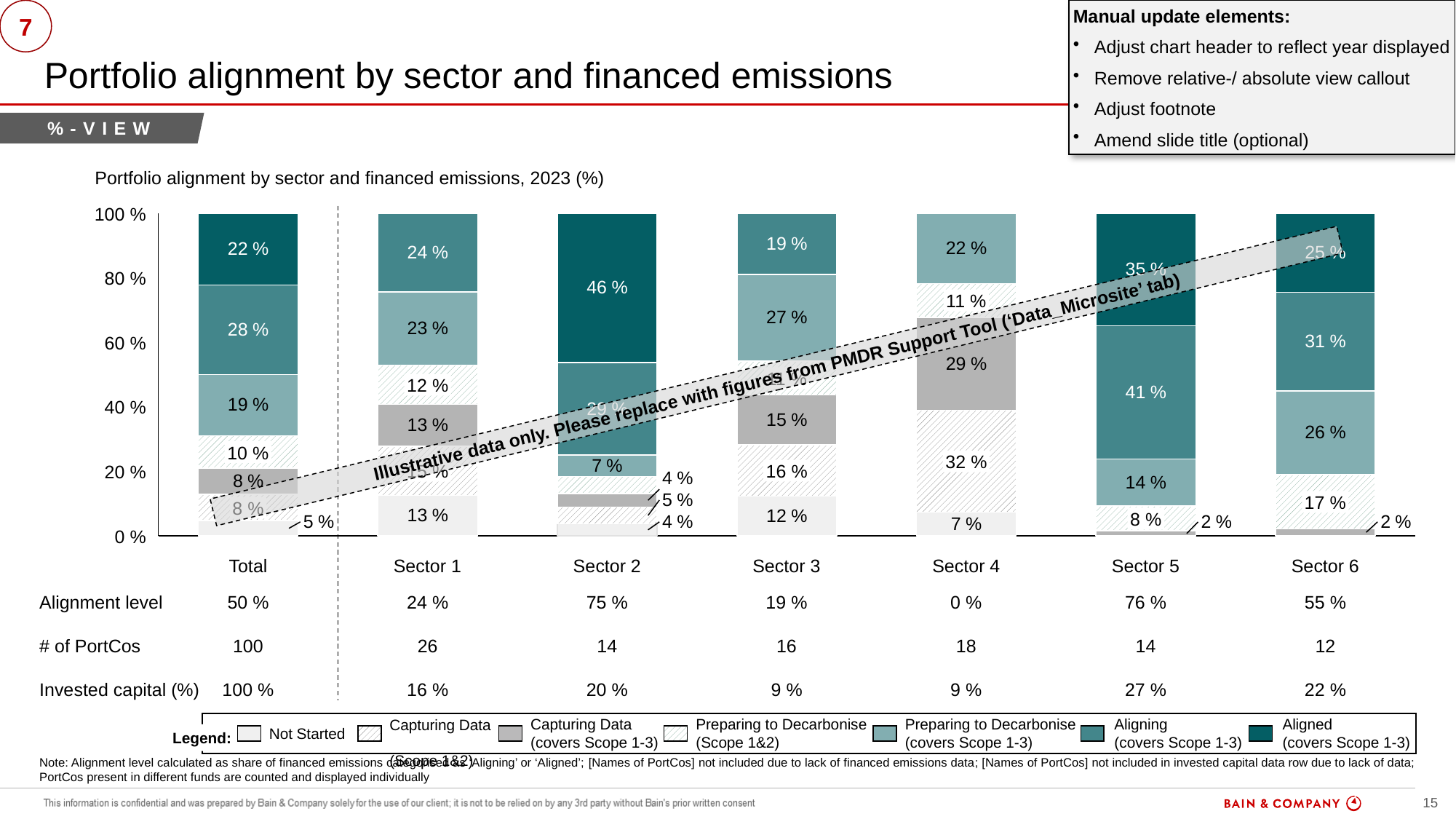
What is the 'Not Started' share for Sector 1? 13 % What is the 'Aligning (covers Scope 1-3)' share for Sector 5? 41 % How many series does the chart legend list? 7 What is the title of the chart? Portfolio alignment by sector and financed emissions, 2023 (%) What is the 'Preparing to Decarbonise (covers Scope 1-3)' share for Sector 6? 26 % Which bar has the largest 'Aligned (covers Scope 1-3)' segment? Sector 2 What is the 'Aligned (covers Scope 1-3)' share for Sector 2? 46 % What is the 'Aligned (covers Scope 1-3)' share for the Total bar? 22 % Which is larger: the 'Aligned (covers Scope 1-3)' share for Sector 5 or for Sector 3? Sector 5 How many categories (bars) are shown along the x axis of the chart? 7 What kind of chart is shown on the slide? Stacked bar chart What is the difference between the 'Aligning (covers Scope 1-3)' shares of Sector 5 and Sector 6? 10 percentage points